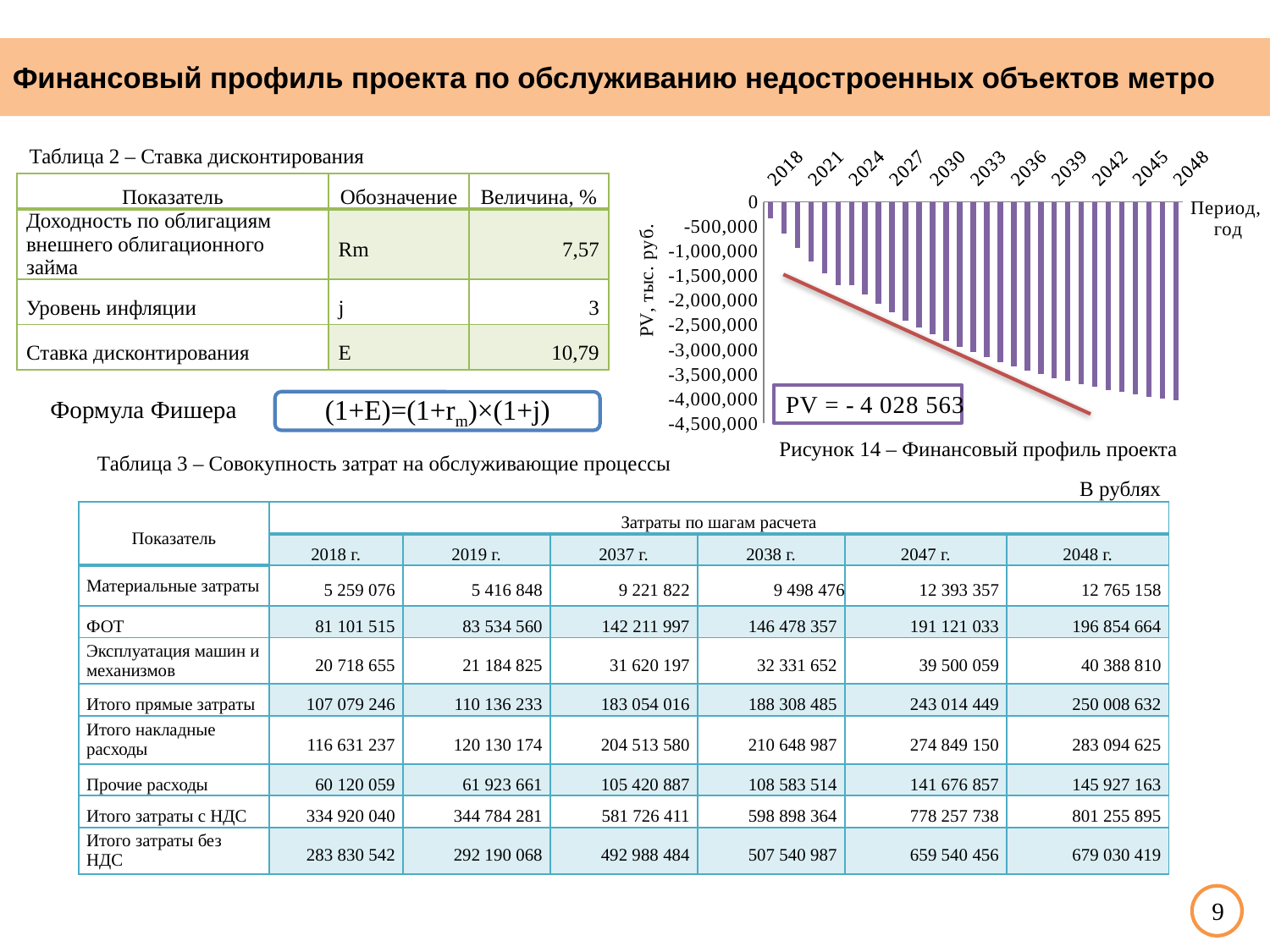
In the chart Рисунок 14, which is larger, the PV value for 2018 or for 2048? 2018 In the chart Рисунок 14, is the PV value for 2048 greater or less than -3,500,000? less In the chart Рисунок 14, which is larger, the PV value for 2021 or for 2045? 2021 What kind of chart is shown in Рисунок 14 – Финансовый профиль проекта? bar chart What is the caption of the chart on the right of the slide? Рисунок 14 – Финансовый профиль проекта In the chart Рисунок 14, do the PV values rise or fall as the years go from 2018 to 2048? fall How many year labels are shown on the x axis of the chart Рисунок 14? 11 In the chart Рисунок 14, is the PV value for 2018 greater or less than -500,000? greater What is the label of the vertical axis of the chart Рисунок 14? PV, тыс. руб. In the chart Рисунок 14, is the PV value for 2033 greater or less than -1,500,000? less What PV value is printed in the annotation box on the chart Рисунок 14? - 4 028 563 In the chart Рисунок 14, which year has the highest (least negative) PV value? 2018